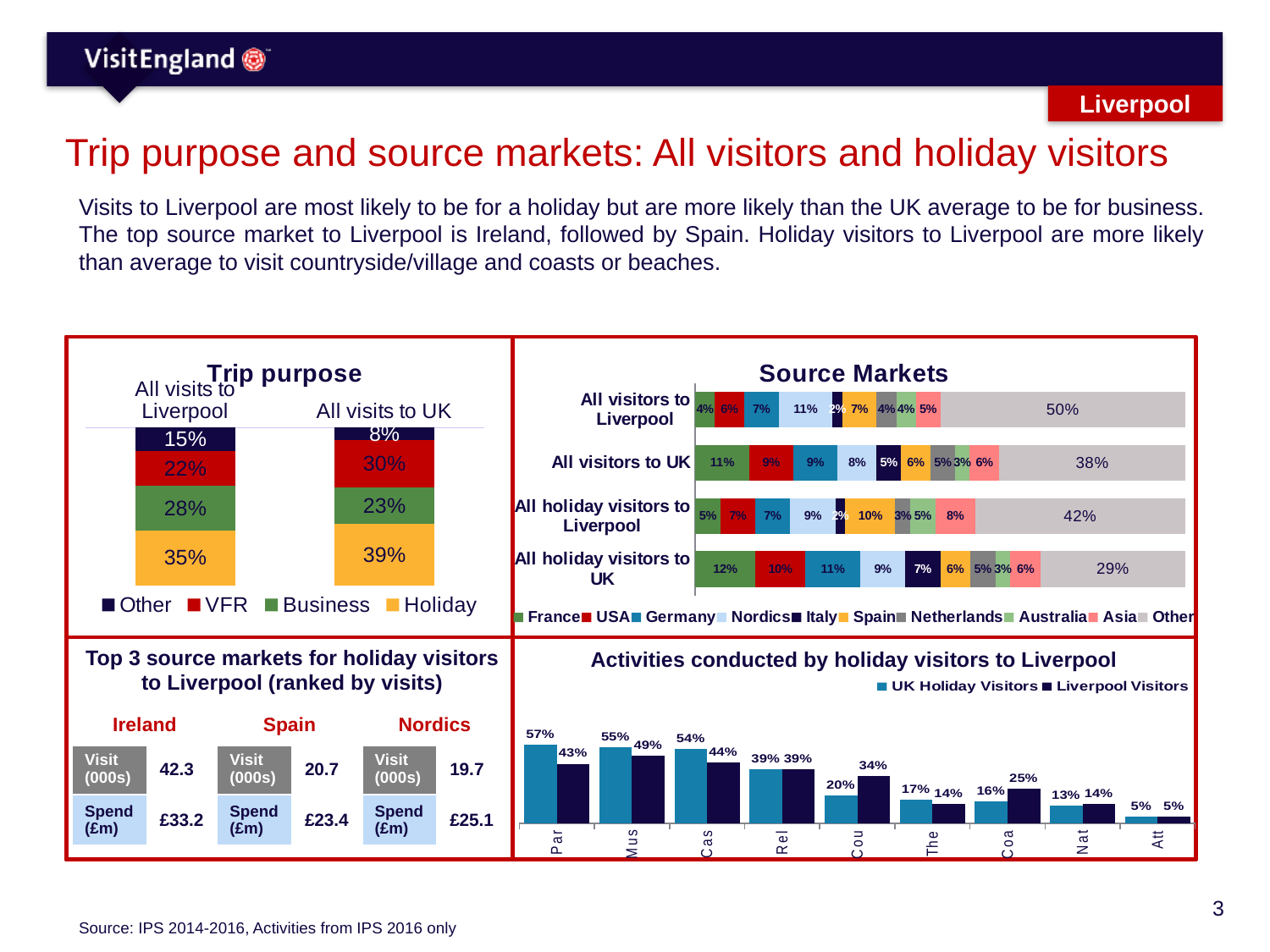
How many series does the legend of the Source Markets chart list? 10 In the Trip purpose chart, what percentage of all visits to Liverpool are for Holiday? 35% In the Trip purpose chart, what percentage of all visits to UK are for Business? 23% In the Activities conducted by holiday visitors to Liverpool chart, which series has the larger value for the category labelled 'Coa': UK Holiday Visitors or Liverpool Visitors? Liverpool Visitors How many series does the legend of the Activities conducted by holiday visitors to Liverpool chart list? 2 How many series does the legend of the Trip purpose chart list? 4 In the Source Markets chart, which category has the largest Other share? All visitors to Liverpool In the Source Markets chart, what is the Spain share for All holiday visitors to Liverpool? 10% In the Source Markets chart, what is the Other share for All visitors to Liverpool? 50% In the Source Markets chart, what is the France share for All holiday visitors to UK? 12% What kind of chart is the Activities conducted by holiday visitors to Liverpool chart? Bar chart In the Trip purpose chart, what is the difference between the Other share for all visits to Liverpool and for all visits to UK? 7 percentage points